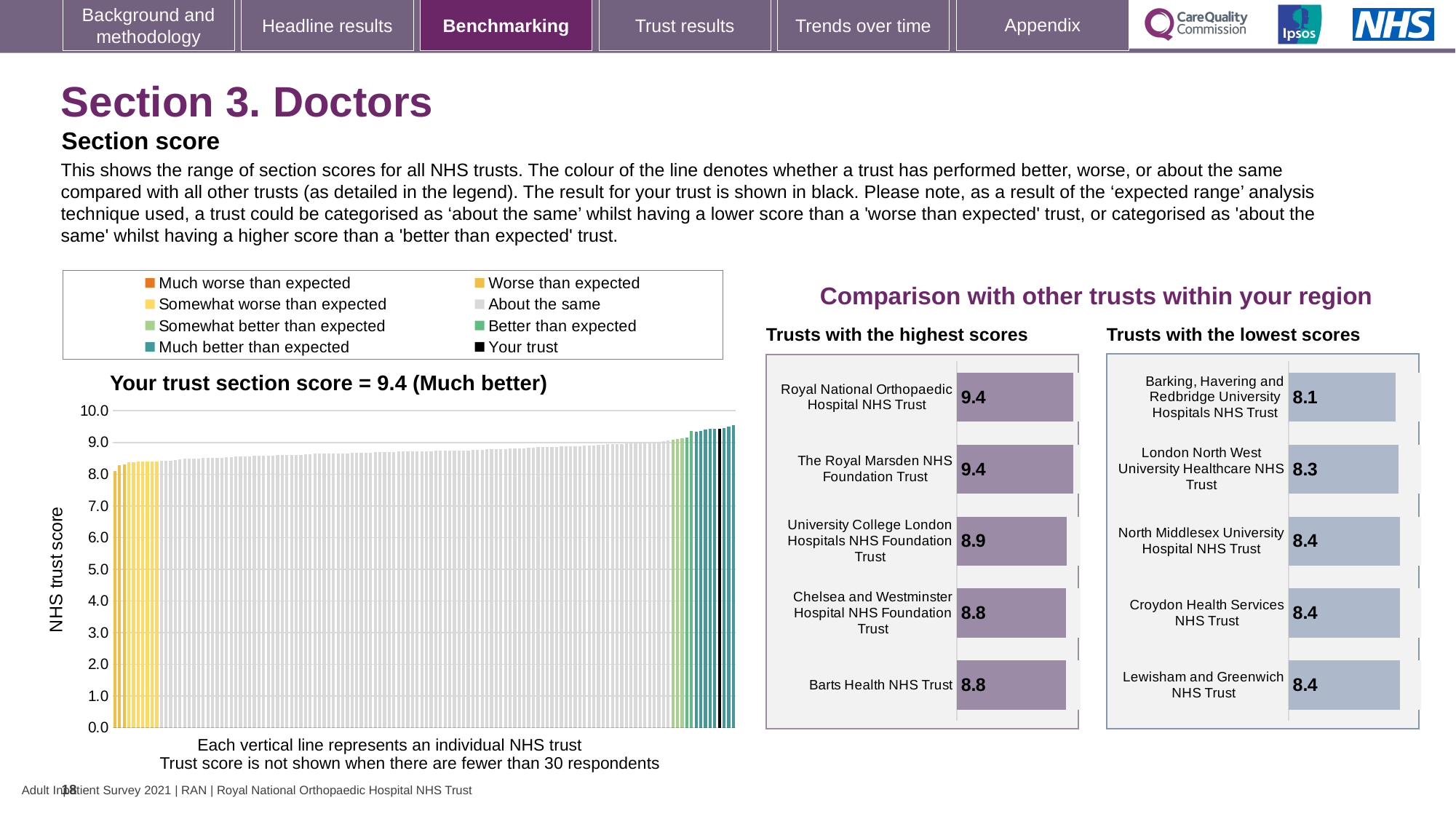
What kind of chart is the large chart on the left showing the range of section scores for all NHS trusts? Bar chart In the 'Trusts with the lowest scores' chart, which trust has the lowest score? Barking, Havering and Redbridge University Hospitals NHS Trust How many trusts are shown in the 'Trusts with the highest scores' chart? 5 In the 'Trusts with the lowest scores' chart, what is the score for Barking, Havering and Redbridge University Hospitals NHS Trust? 8.1 In the large chart on the left, what is your trust's section score? 9.4 In the 'Trusts with the highest scores' chart, what is the difference between the scores of Royal National Orthopaedic Hospital NHS Trust and Barts Health NHS Trust? 0.6 In the 'Trusts with the highest scores' chart, what is the score for University College London Hospitals NHS Foundation Trust? 8.9 What is the y-axis label of the large chart on the left? NHS trust score In the 'Trusts with the lowest scores' chart, what is the difference between the scores of Lewisham and Greenwich NHS Trust and Barking, Havering and Redbridge University Hospitals NHS Trust? 0.3 How many trusts are shown in the 'Trusts with the lowest scores' chart? 5 In the 'Trusts with the highest scores' chart, which has the higher score: University College London Hospitals NHS Foundation Trust or Chelsea and Westminster Hospital NHS Foundation Trust? University College London Hospitals NHS Foundation Trust How many entries does the legend above the large chart on the left list? 8